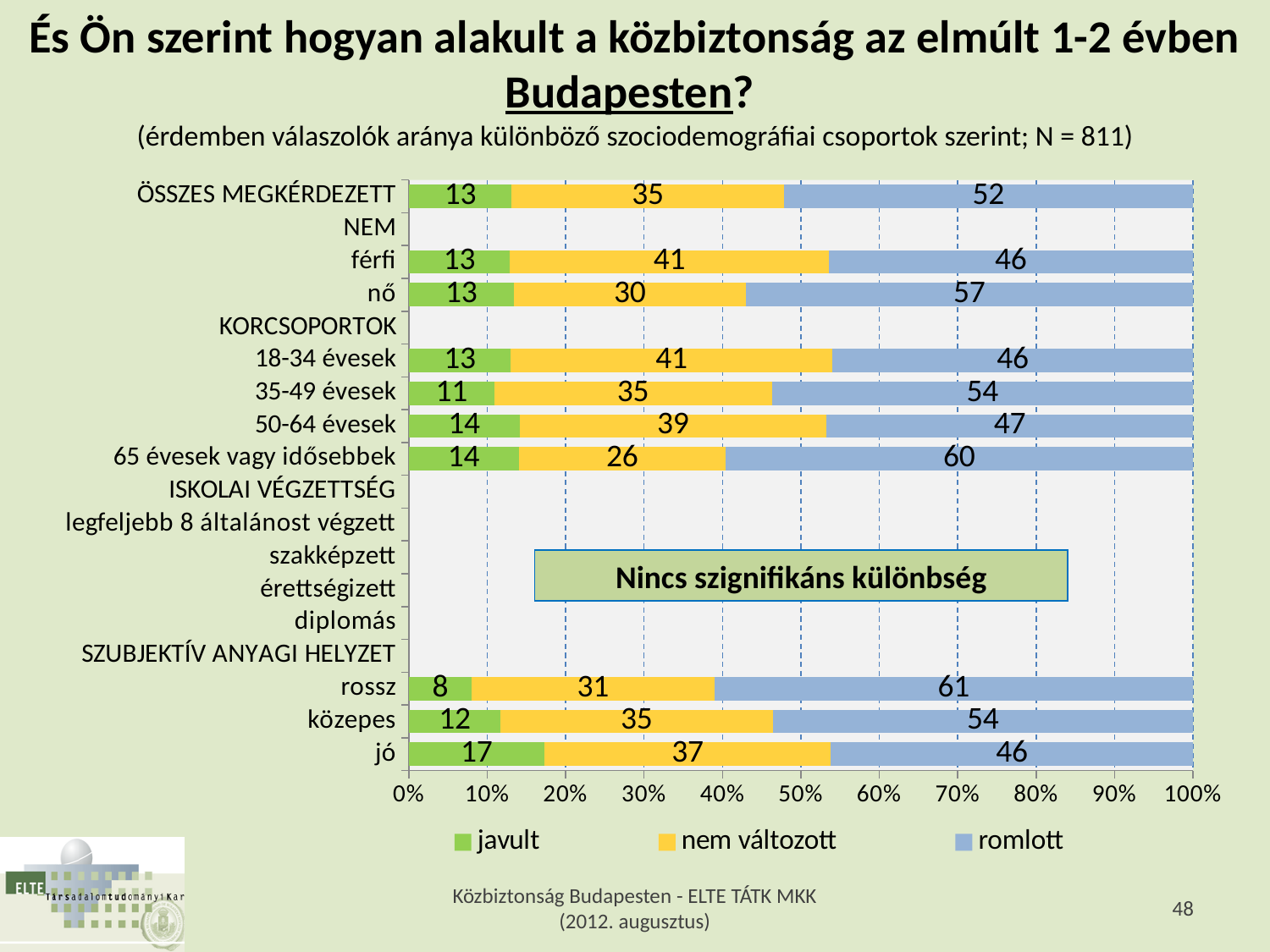
Which category has the lowest "javult" value? rossz What is the value of "romlott" for 65 évesek vagy idősebbek? 60 What is the value of "romlott" for ÖSSZES MEGKÉRDEZETT? 52 What text is shown in the box over the ISKOLAI VÉGZETTSÉG rows where no bars are plotted? Nincs szignifikáns különbség What is the value of "javult" for jó? 17 Which is larger: the "nem változott" value for 18-34 évesek or for 65 évesek vagy idősebbek? 18-34 évesek How many series does the legend list? 3 What is the difference between the "romlott" values for nő and férfi? 11 Which category has the highest "romlott" value? rossz What is the total of the stacked bar for közepes? 101 What kind of chart is shown on the slide? Stacked bar chart What is the value of "nem változott" for férfi? 41